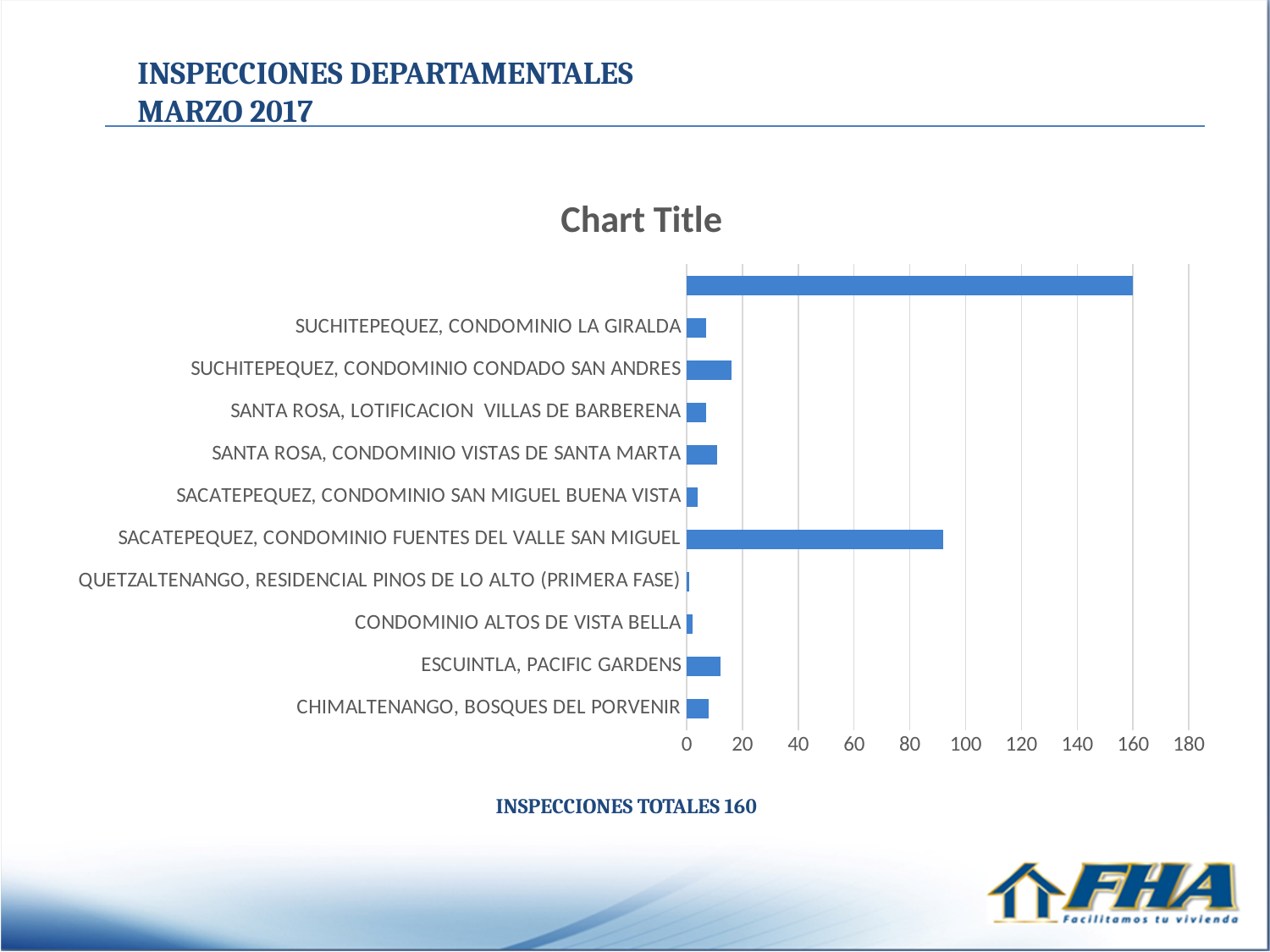
Is the value for SANTA ROSA, CONDOMINIO VISTAS DE SANTA MARTA greater or less than 20? less Is the value for SACATEPEQUEZ, CONDOMINIO FUENTES DEL VALLE SAN MIGUEL greater or less than 100? less Which is larger: the value for SUCHITEPEQUEZ, CONDOMINIO CONDADO SAN ANDRES or the value for SACATEPEQUEZ, CONDOMINIO SAN MIGUEL BUENA VISTA? SUCHITEPEQUEZ, CONDOMINIO CONDADO SAN ANDRES Is the value for ESCUINTLA, PACIFIC GARDENS greater or less than 20? less How many bars are plotted in the chart? 11 Which is larger: the value for SACATEPEQUEZ, CONDOMINIO FUENTES DEL VALLE SAN MIGUEL or the value for SUCHITEPEQUEZ, CONDOMINIO CONDADO SAN ANDRES? SACATEPEQUEZ, CONDOMINIO FUENTES DEL VALLE SAN MIGUEL What is the highest value shown on the horizontal axis of the chart? 180 What kind of chart is shown on the slide? bar chart What is the title shown above the chart? Chart Title Among the labeled categories, which has the highest value? SACATEPEQUEZ, CONDOMINIO FUENTES DEL VALLE SAN MIGUEL